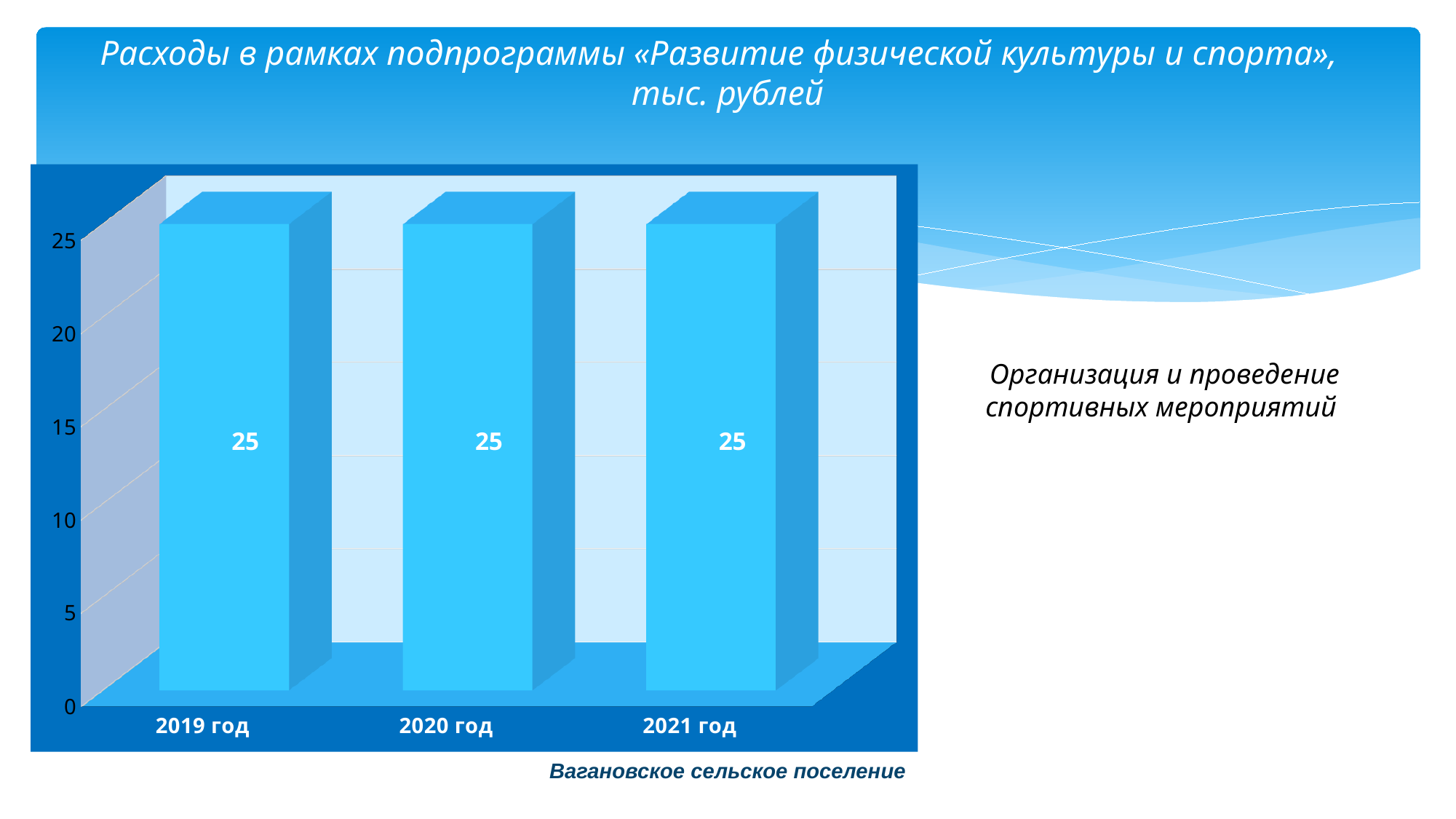
How many categories (years) are shown on the x axis? 3 Is the value for 2021 год greater or less than 20? greater What kind of chart is shown on the slide? bar chart What is the highest tick value shown on the vertical axis? 25 What is the value for 2020 год? 25 Do the values rise, fall, or stay the same from 2019 год to 2021 год? stay the same In what units are the values on the chart expressed, according to the title? тыс. рублей What is the difference between the values for 2021 год and 2019 год? 0 Is the value for 2020 год larger than, smaller than, or equal to the value for 2019 год? equal What is the value for 2021 год? 25 What is the value for 2019 год? 25